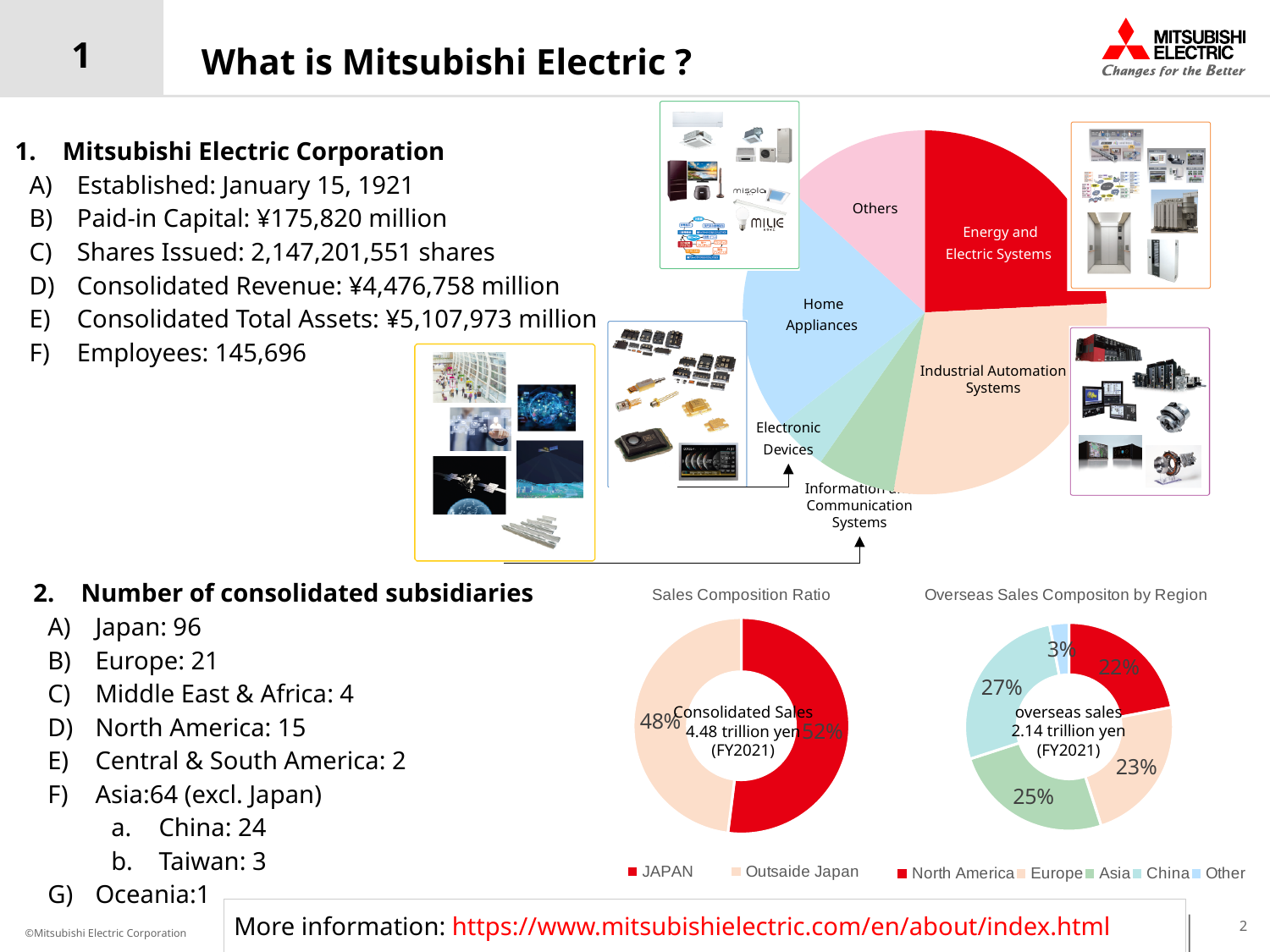
In the Sales Composition Ratio chart, which is larger, JAPAN or Outside Japan? JAPAN How many regions does the legend of the Overseas Sales Composition by Region chart list? 5 How many segments does the large pie chart at the top right of the slide have? 6 In the Sales Composition Ratio chart, what share of sales is JAPAN? 52% In the Overseas Sales Composition by Region chart, what share does China have? 27% In the Overseas Sales Composition by Region chart, what is the difference between the Asia and Europe shares? 2% In the Overseas Sales Composition by Region chart, which region has the smallest share? Other In the Overseas Sales Composition by Region chart, what share does North America have? 22% In the Overseas Sales Composition by Region chart, which region has the largest share? China In the Sales Composition Ratio chart, what share of sales is Outside Japan? 48% In the Sales Composition Ratio chart, what is the difference between the JAPAN and Outside Japan shares? 4% In the large pie chart at the top right, which segment is larger, Home Appliances or Electronic Devices? Home Appliances